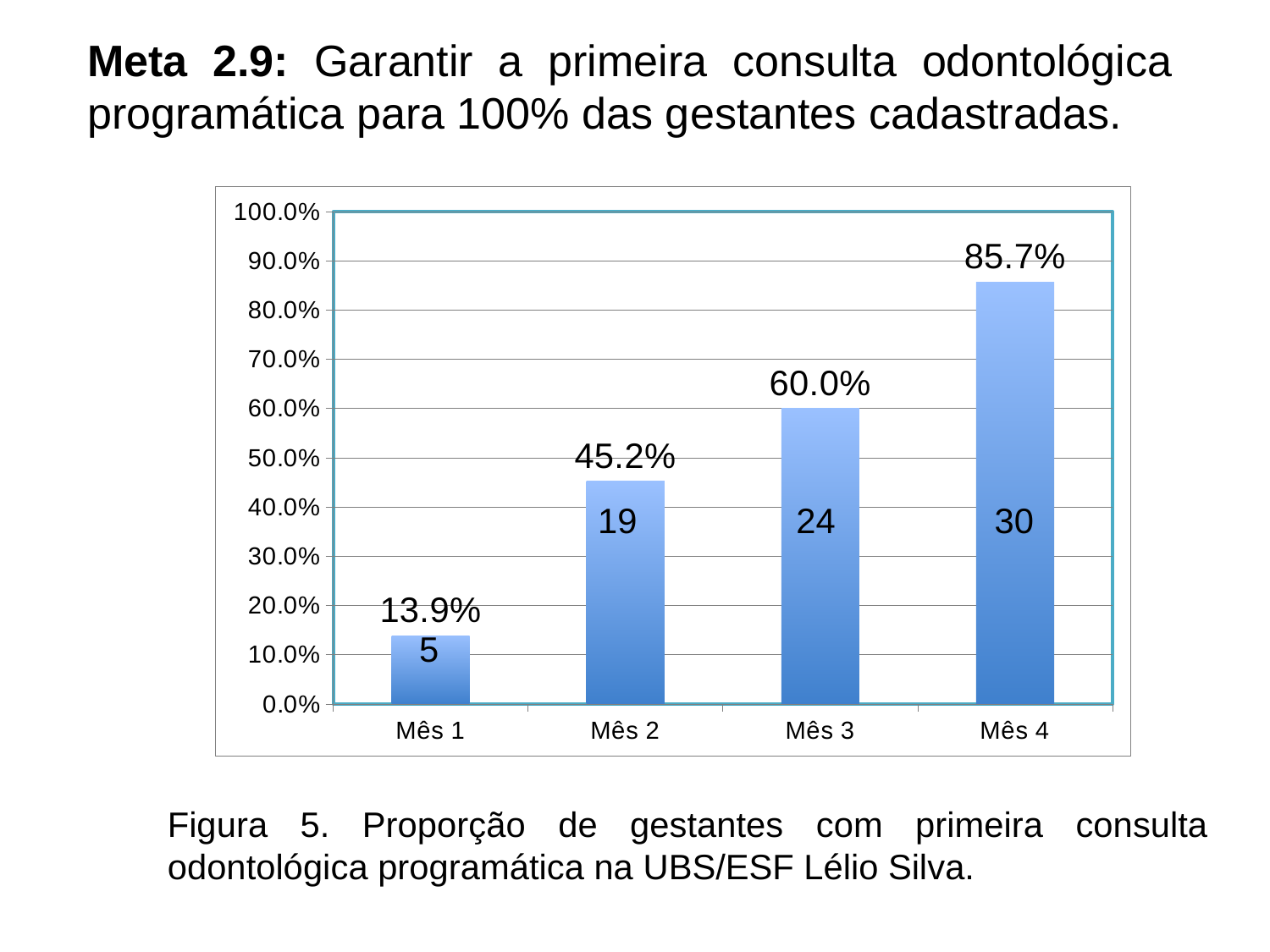
Is the value for Mês 4 greater or less than 80.0%? greater What kind of chart is shown on the slide? bar chart What is the difference in percentage points between Mês 4 and Mês 3? 25.7 What is the percentage value shown for Mês 1? 13.9% How many months are shown on the x axis? 4 What count is printed inside the bar for Mês 2? 19 Which month has the highest percentage? Mês 4 Do the percentages rise or fall from Mês 1 to Mês 4? rise What count is printed inside the bar for Mês 4? 30 Which month has the lowest percentage? Mês 1 Which is larger, the percentage for Mês 2 or for Mês 3? Mês 3 What is the percentage value shown for Mês 3? 60.0%